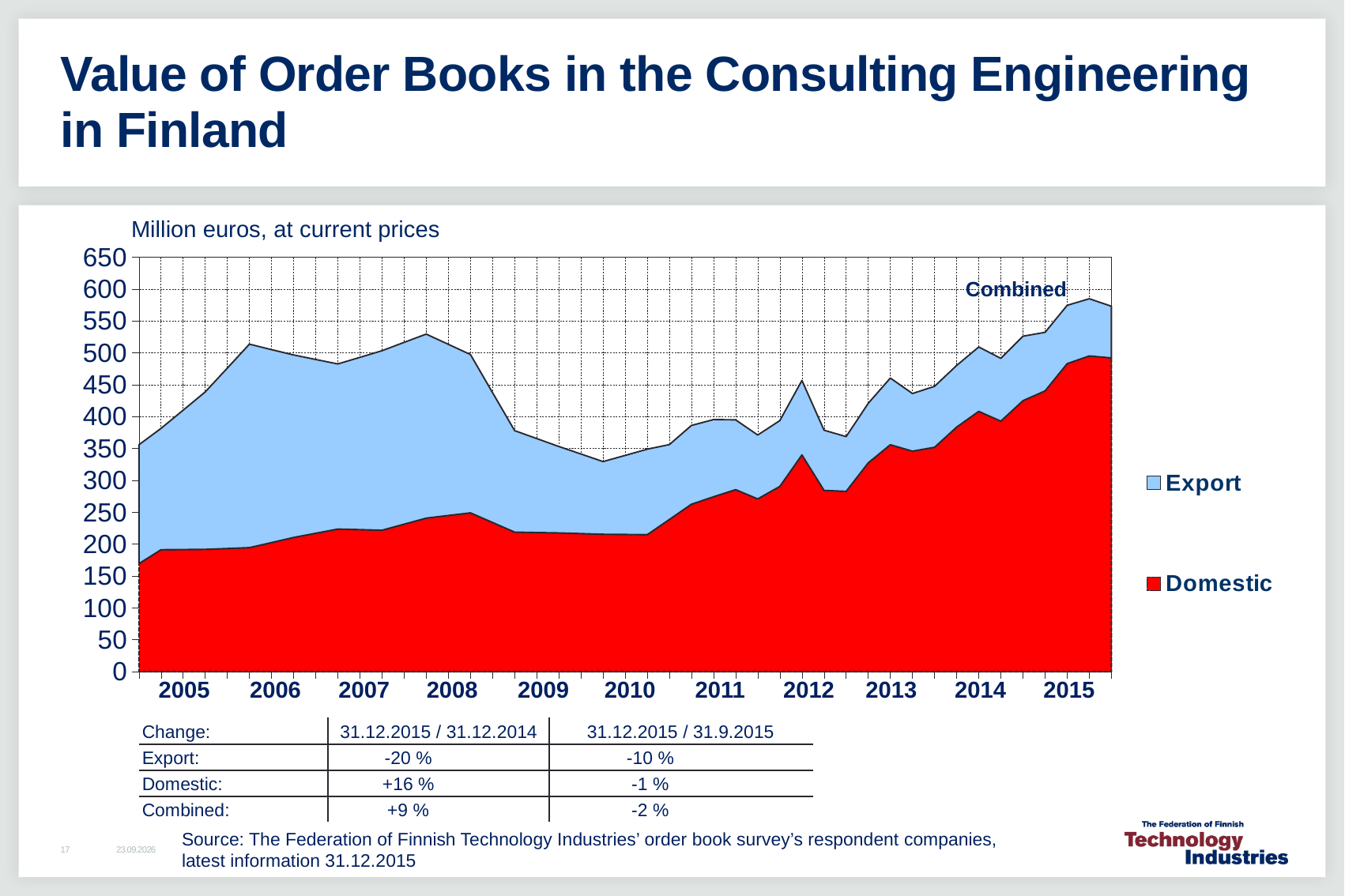
Is the Combined value at its 2015 peak greater or less than 550? greater Is the Combined value at its 2008 peak greater or less than 500? greater Does the Domestic value rise or fall from 2012 to 2015? rise What unit is the chart's vertical axis measured in, according to the label above the chart? Million euros, at current prices Which series are listed in the chart legend? Export and Domestic How many years are labelled on the x axis of the chart? 11 How many series does the chart legend list? 2 Is the Domestic value at the start of 2005 greater or less than 200? less Does the Combined value rise or fall from 2008 to 2010? fall What kind of chart is shown on the slide? Stacked area chart